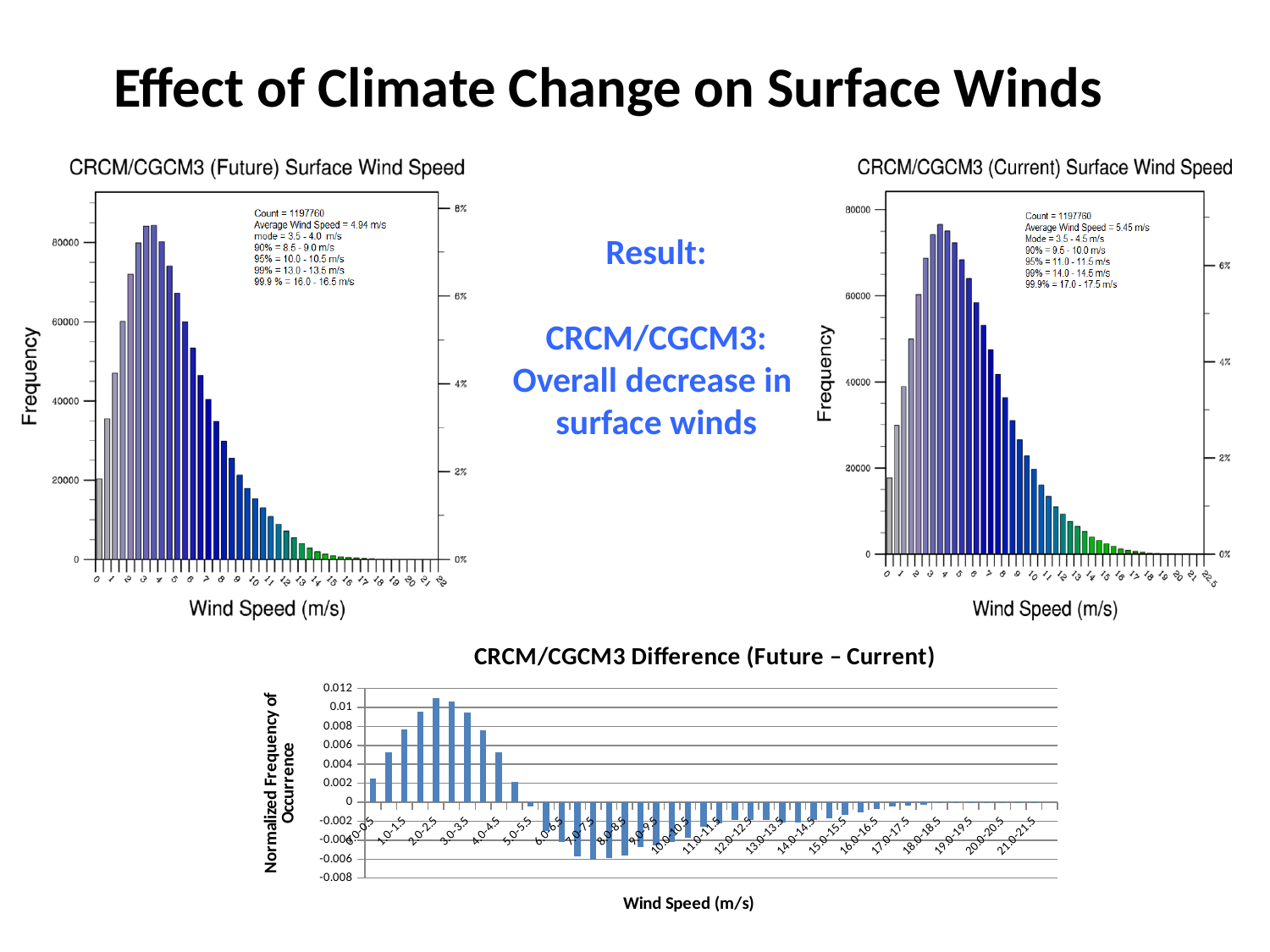
What kind of chart is the CRCM/CGCM3 Difference (Future – Current) chart? bar chart What is the difference between the average wind speed on the Current chart and the average wind speed on the Future chart? 0.51 m/s What is the y-axis label of the CRCM/CGCM3 Difference (Future – Current) chart? Normalized Frequency of Occurrence On the CRCM/CGCM3 (Future) Surface Wind Speed chart, what is the Average Wind Speed given in the text box? 4.94 m/s On the CRCM/CGCM3 (Current) Surface Wind Speed chart, what is the Average Wind Speed given in the text box? 5.45 m/s On the CRCM/CGCM3 (Future) Surface Wind Speed chart, is the frequency of the tallest bar greater or less than 80000? greater On the CRCM/CGCM3 (Current) Surface Wind Speed chart, what wind speed range is given for the 99.9% level? 17.0 - 17.5 m/s On the CRCM/CGCM3 Difference (Future – Current) chart, is the value for the 0.0-0.5 bin greater or less than 0.004? less On the CRCM/CGCM3 (Future) Surface Wind Speed chart, what is the Count given in the text box? 1197760 Which chart reports the higher average wind speed, the Future chart or the Current chart? Current On the CRCM/CGCM3 (Current) Surface Wind Speed chart, is the frequency of the tallest bar greater or less than 80000? less